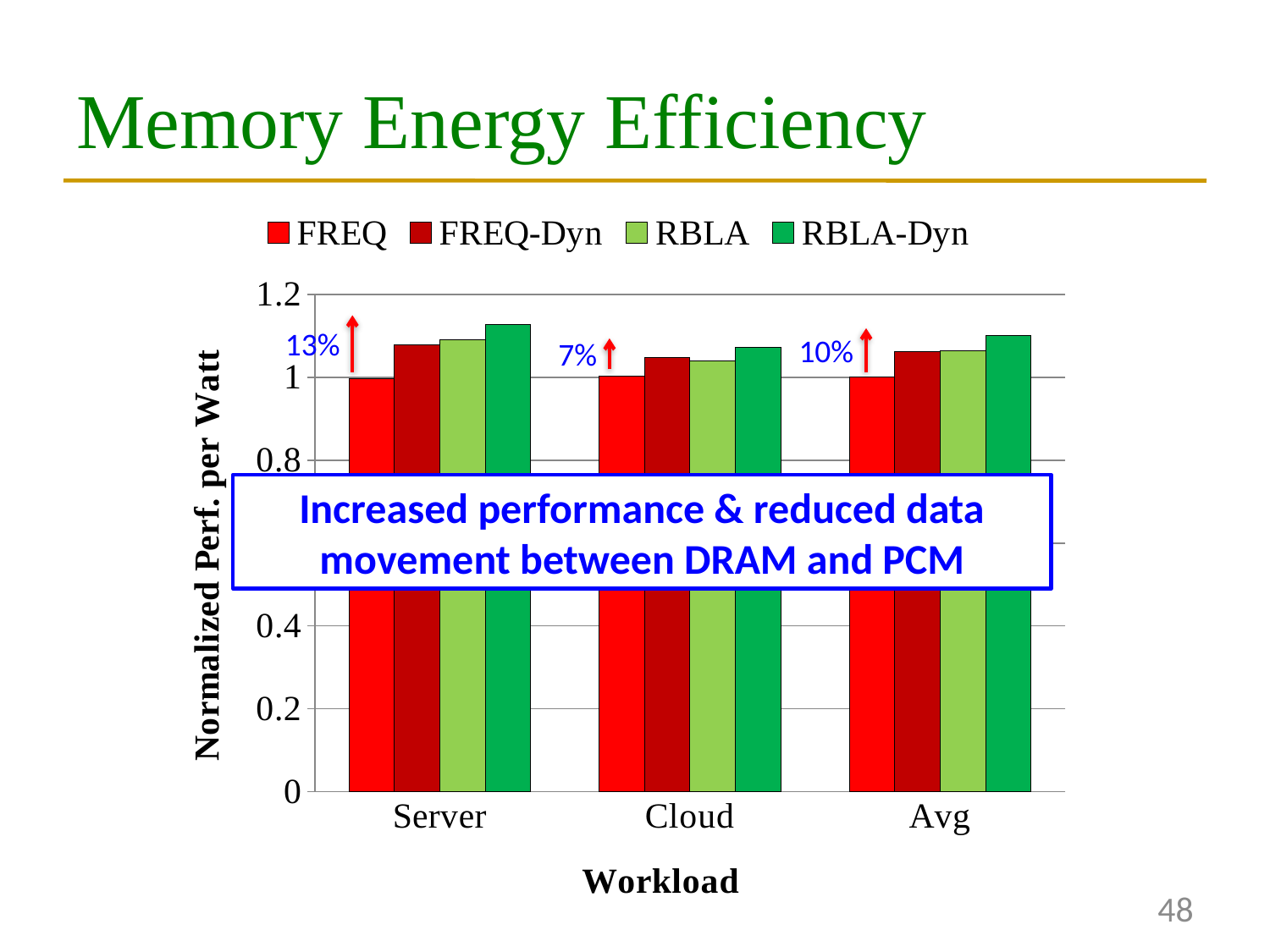
How many series does the legend list? 4 Which series is shown in light green in the legend? RBLA What kind of chart is shown on the slide? bar chart For the Server workload, which series has the highest value? RBLA-Dyn How many workload categories are shown on the x axis? 3 What percentage improvement is annotated above the Cloud workload? 7% What percentage improvement is annotated above the Server workload? 13% For the Avg workload, which series has the lowest value? FREQ What is the y-axis title of the chart? Normalized Perf. per Watt What percentage improvement is annotated above the Avg workload? 10% Is the value of RBLA-Dyn for the Server workload greater or less than 1? greater